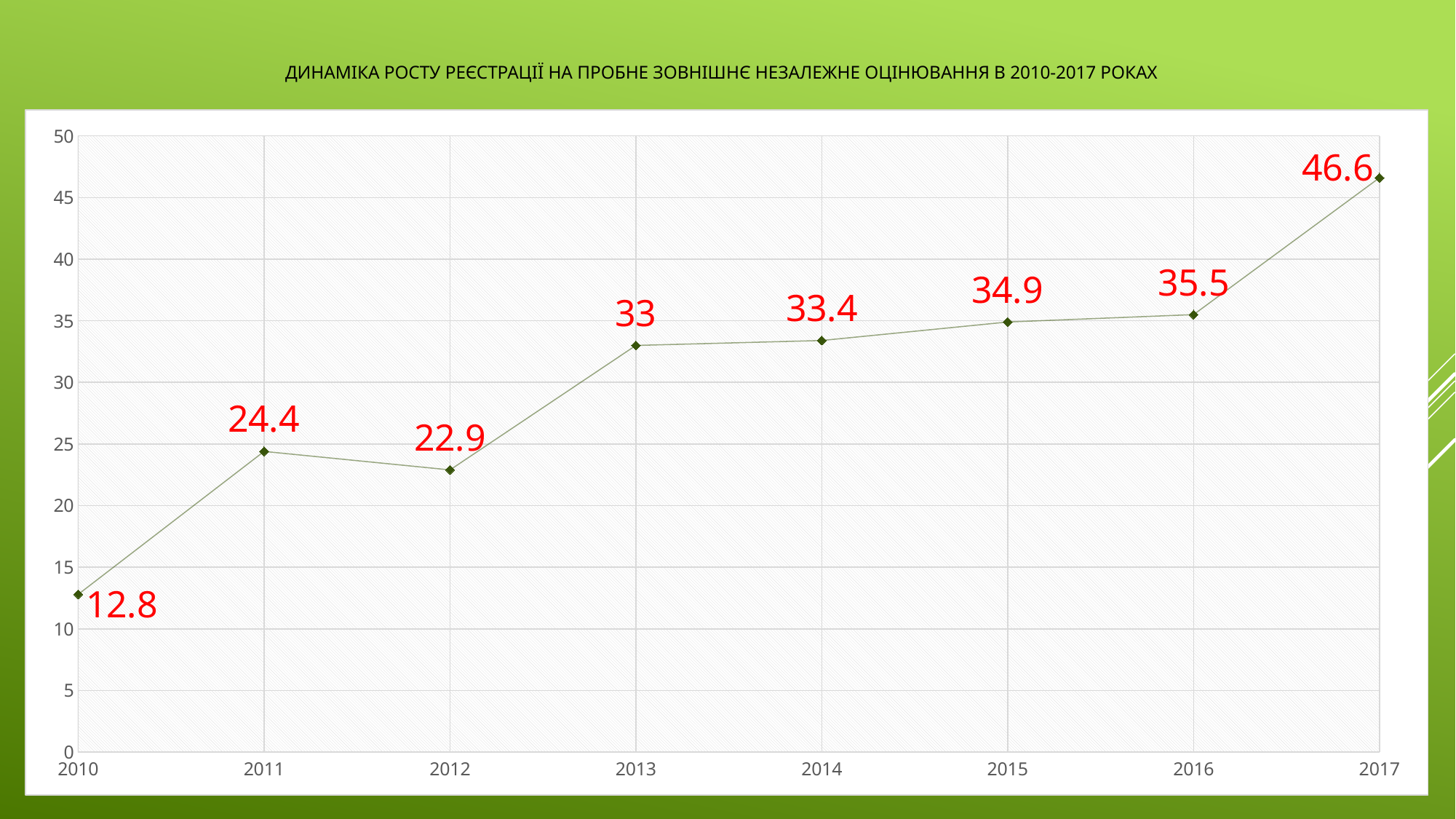
What is the difference between the values for 2017 and 2016? 11.1 What is the value for 2016? 35.5 Which year has the highest value? 2017 Do the values generally rise or fall from 2010 to 2017? rise Is the value for 2015 greater or less than 30? greater What is the value for 2010? 12.8 What kind of chart is shown on the slide? line chart How many years are plotted on the chart? 8 What is the difference between the values for 2011 and 2012? 1.5 Which year has the lowest value? 2010 Which is larger, the value for 2011 or the value for 2012? 2011 What is the value for 2013? 33